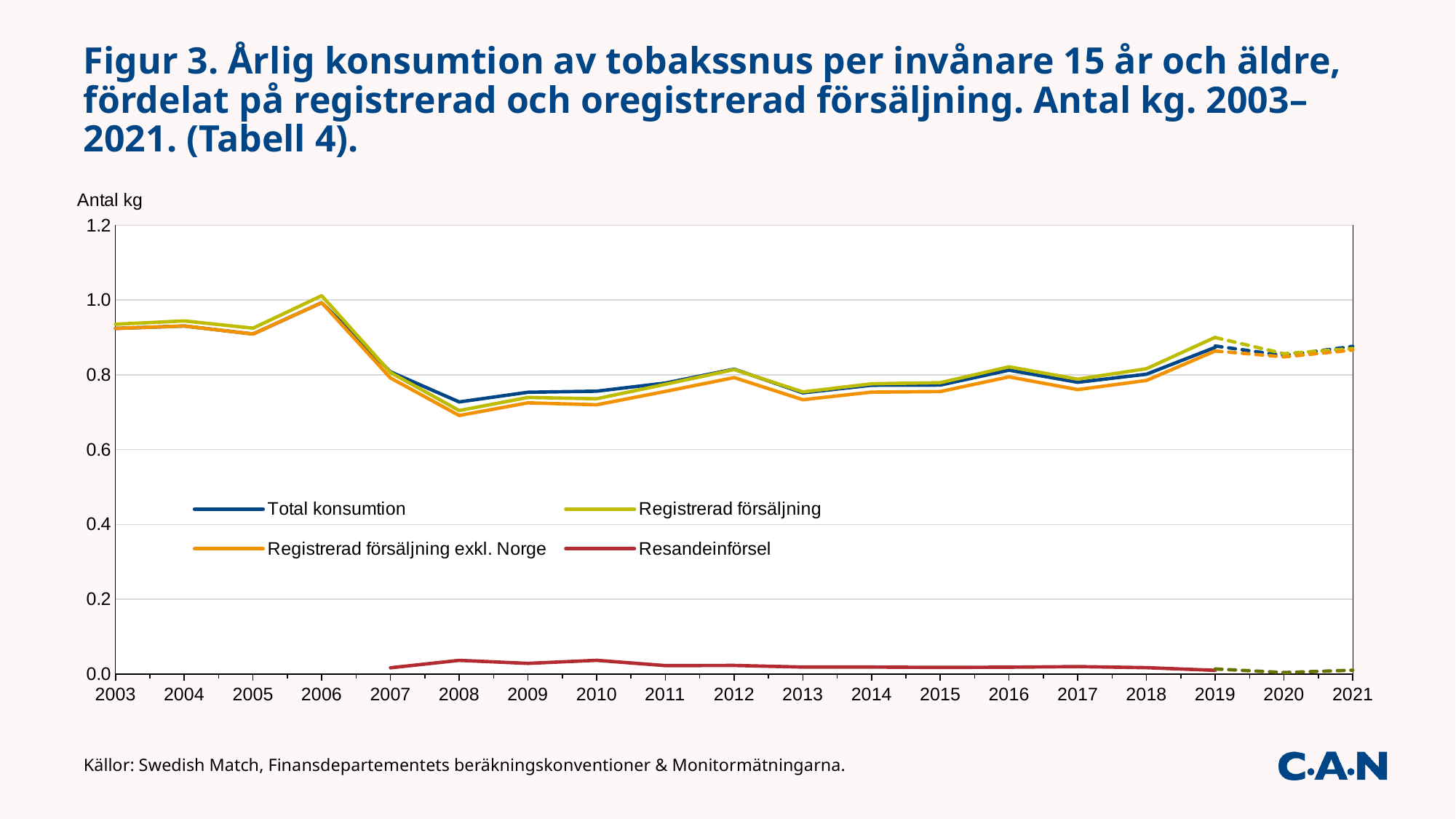
What kind of chart is shown on the slide? line chart How many years are shown along the x axis? 19 Which is larger in 2012, Total konsumtion or Resandeinförsel? Total konsumtion Is the value for Total konsumtion in 2008 greater or less than 0.8? less In which year is Total konsumtion at its lowest? 2008 What is the label on the y axis? Antal kg How many series does the legend list? 4 Is the value for Total konsumtion in 2003 greater or less than 0.8? greater Does Total konsumtion rise or fall between 2006 and 2008? fall Is the value for Resandeinförsel in 2010 greater or less than 0.2? less In which year does the Resandeinförsel series begin? 2007 In which year does Registrerad försäljning reach its highest value? 2006